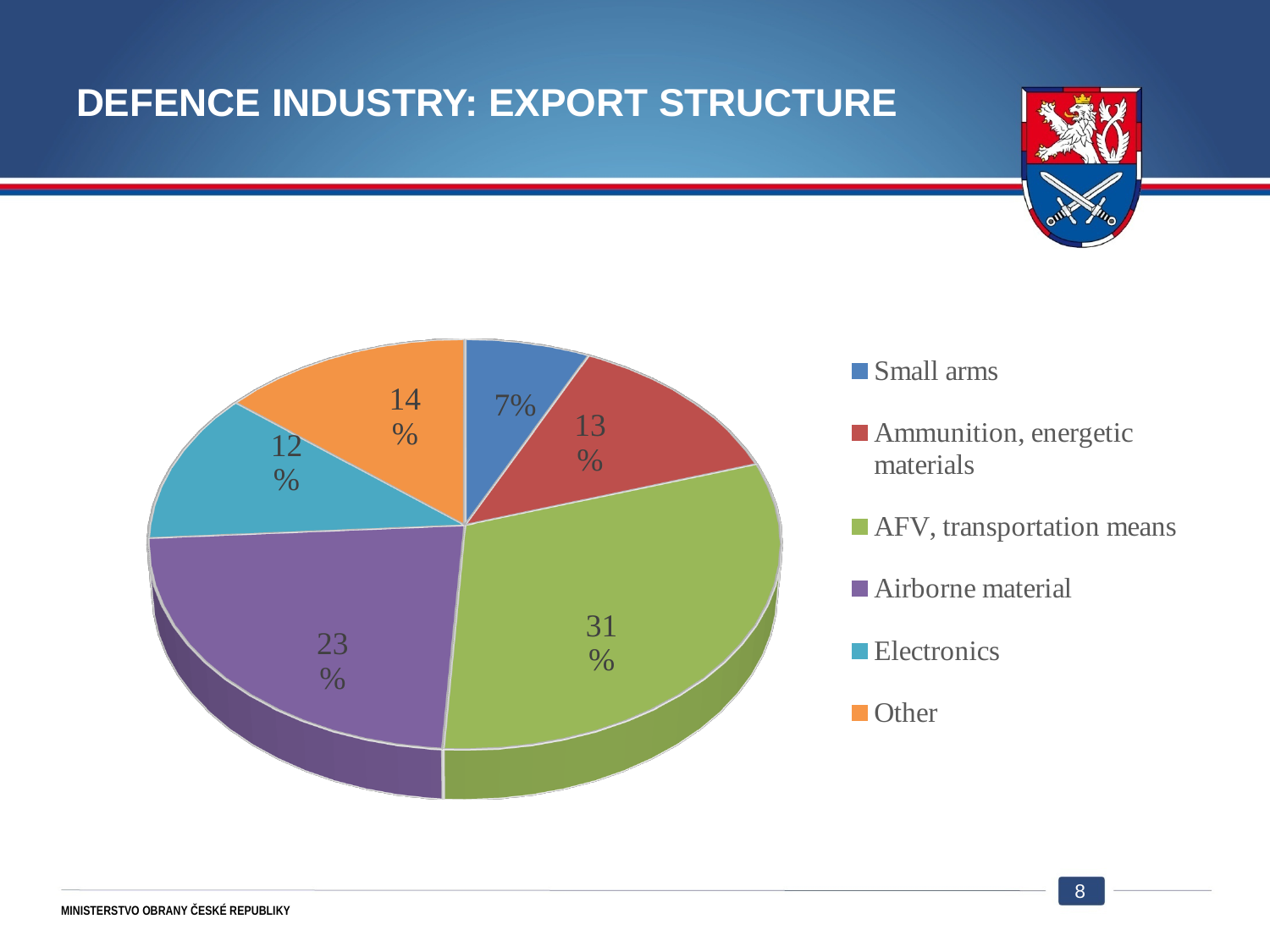
What is the difference in percentage points between AFV, transportation means and Airborne material? 8 What share of exports does Airborne material account for? 23% Which is larger, the share for Other or the share for Electronics? Other What share of exports does Electronics account for? 12% What share of exports does AFV, transportation means account for? 31% Which category has the largest share of the pie? AFV, transportation means What share of exports does Small arms account for? 7% What kind of chart is shown on the slide? Pie chart Which category has the smallest share of the pie? Small arms How many categories are shown in the pie chart? 6 What is the share for Ammunition, energetic materials? 13% What colour represents Other in the pie chart? Orange